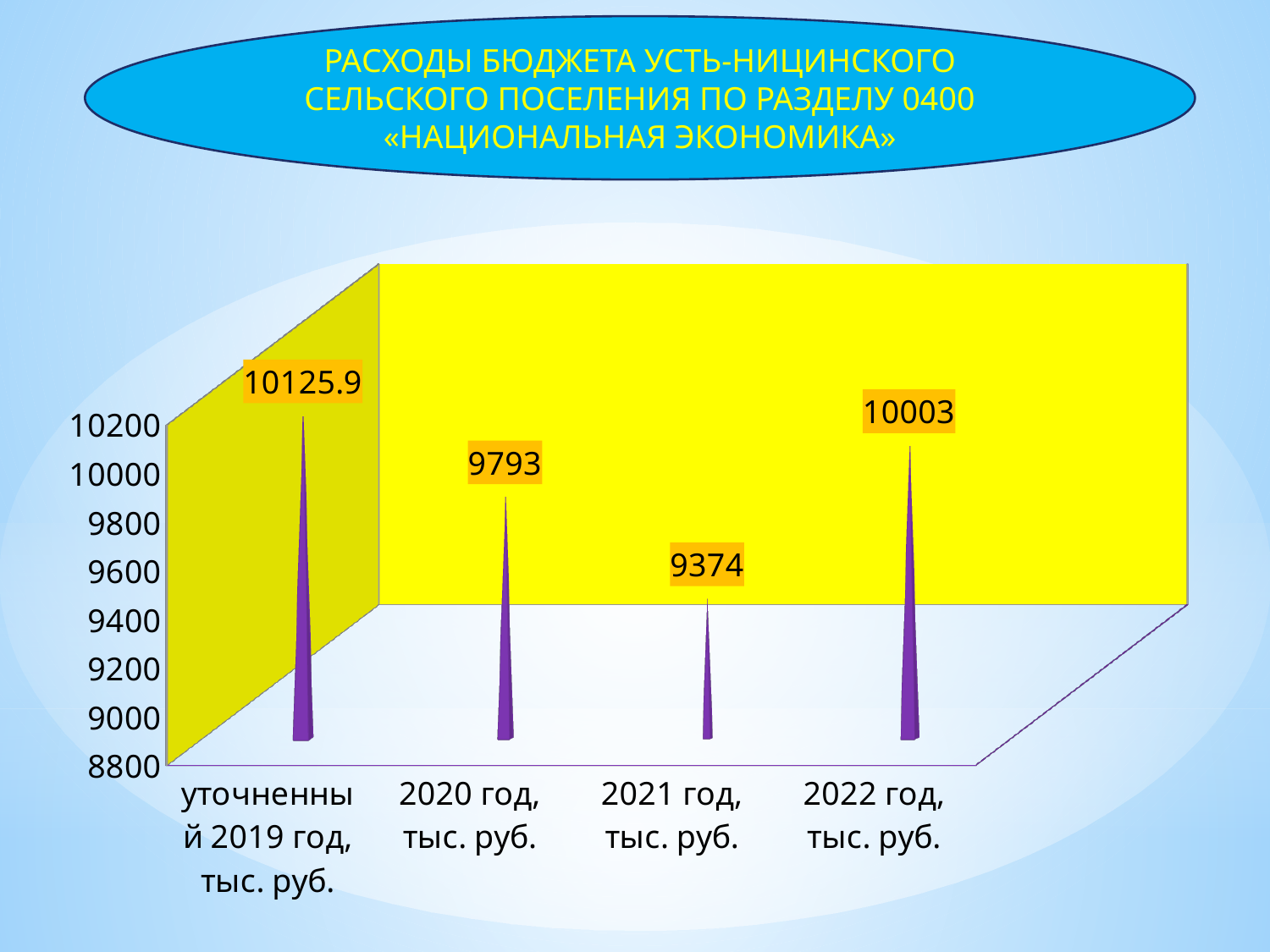
What is the value for 2021 год, тыс. руб.? 9374 What is the difference between the values for 2020 год and 2021 год? 419 What kind of chart is shown on the slide? bar chart Do the values rise or fall from уточненный 2019 год to 2021 год? fall What is the difference between the values for 2022 год and 2021 год? 629 What is the value for 2022 год, тыс. руб.? 10003 What is the value for уточненный 2019 год, тыс. руб.? 10125.9 Which category has the lowest value? 2021 год, тыс. руб. Which category has the highest value? уточненный 2019 год, тыс. руб. How many categories are shown on the chart? 4 Which is larger, the value for 2020 год or the value for 2022 год? 2022 год, тыс. руб. What is the value for 2020 год, тыс. руб.? 9793